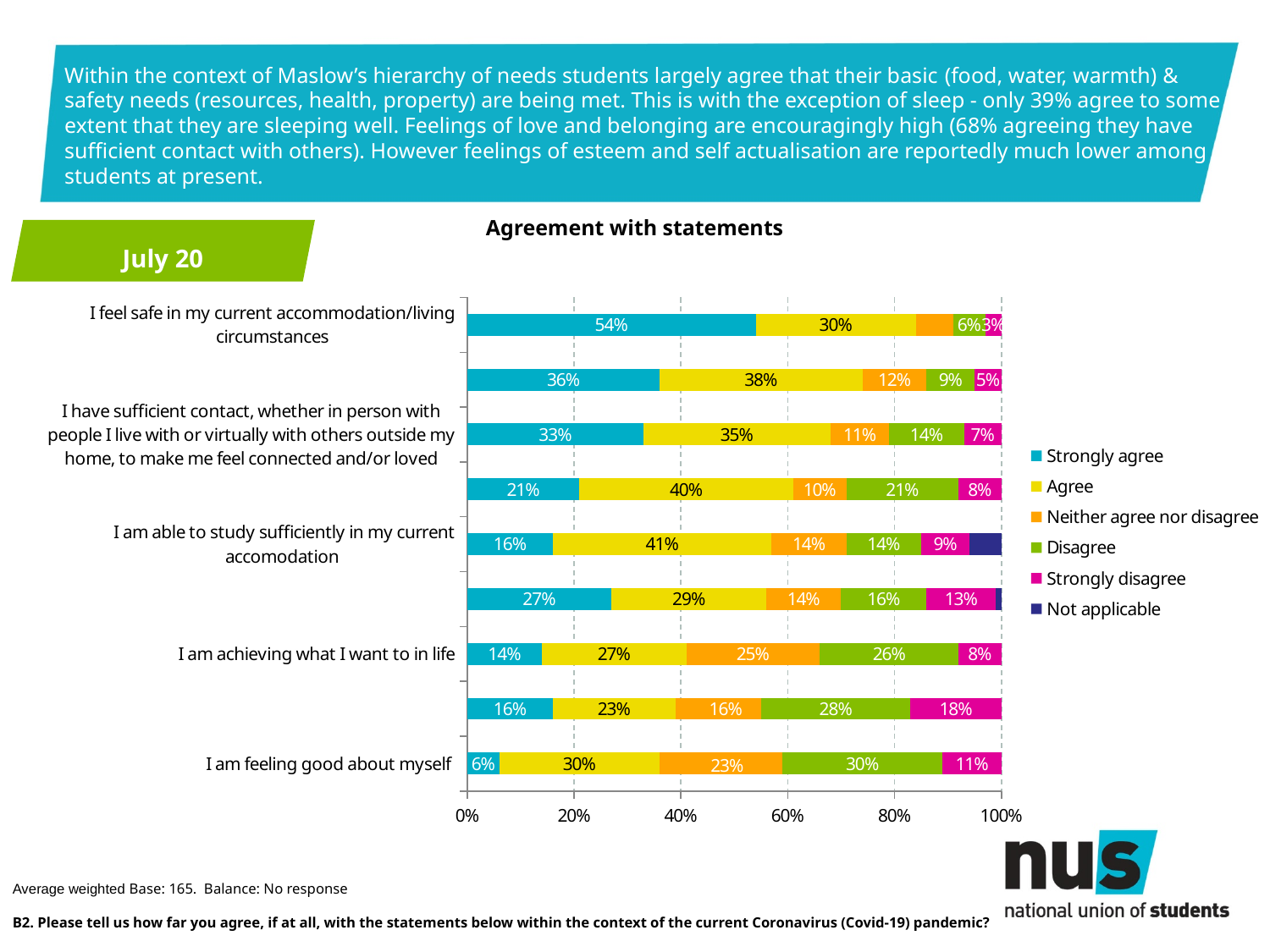
What type of chart is shown on the slide? Stacked bar chart What percentage of students agree with the statement "I am feeling good about myself"? 30% What percentage of students strongly agree with the statement "I feel safe in my current accommodation/living circumstances"? 54% Among the labelled statements, which has the highest Strongly agree percentage? I feel safe in my current accommodation/living circumstances What percentage of students strongly disagree with the statement "I am achieving what I want to in life"? 8% For the statement "I feel safe in my current accommodation/living circumstances", how many percentage points higher is Strongly agree than Agree? 24 percentage points Among the labelled statements, which has the lowest Strongly agree percentage? I am feeling good about myself What percentage of students neither agree nor disagree with the statement "I am able to study sufficiently in my current accomodation"? 14% What percentage of students disagree with the statement "I have sufficient contact, whether in person with people I live with or virtually with others outside my home, to make me feel connected and/or loved"? 14% Which statement has a higher Agree percentage: "I am able to study sufficiently in my current accomodation" or "I am achieving what I want to in life"? I am able to study sufficiently in my current accomodation What is the combined percentage of Strongly agree and Agree for the statement "I have sufficient contact, whether in person with people I live with or virtually with others outside my home, to make me feel connected and/or loved"? 68% How many series does the chart legend list? 6